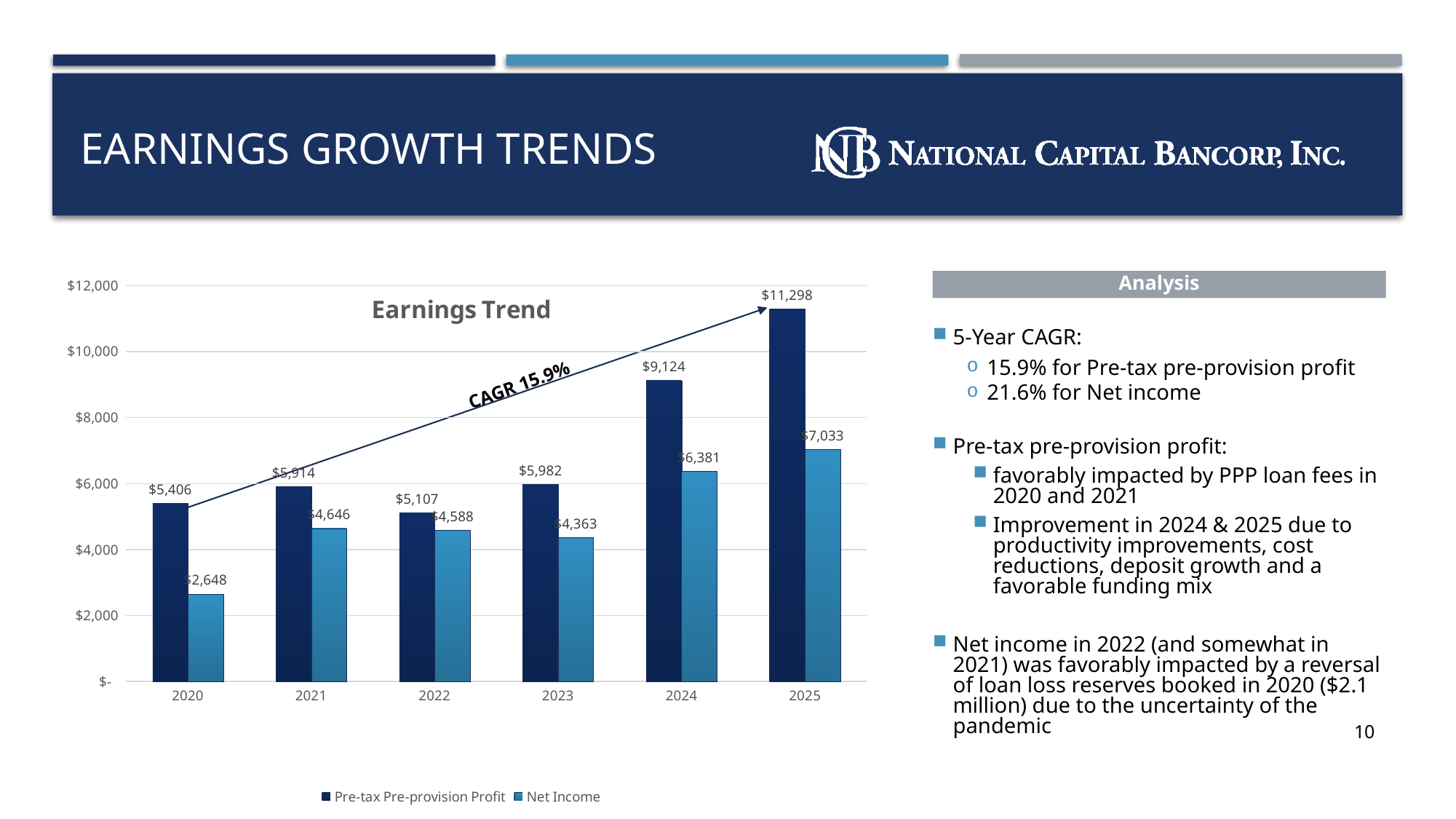
What is the Pre-tax Pre-provision Profit for 2025? $11,298 Which year has the lowest Pre-tax Pre-provision Profit? 2022 Which year has the highest Pre-tax Pre-provision Profit? 2025 What type of chart is the Earnings Trend chart? Bar chart What is the difference between Pre-tax Pre-provision Profit and Net Income in 2025? $4,265 Which is larger: Net Income in 2022 or Net Income in 2023? Net Income in 2022 Is the Pre-tax Pre-provision Profit for 2024 greater or less than $8,000? greater How many years are shown on the x axis of the Earnings Trend chart? 6 Which year has the lowest Net Income? 2020 What is the Net Income for 2020? $2,648 How many series does the legend of the Earnings Trend chart list? 2 What is the Net Income for 2024? $6,381